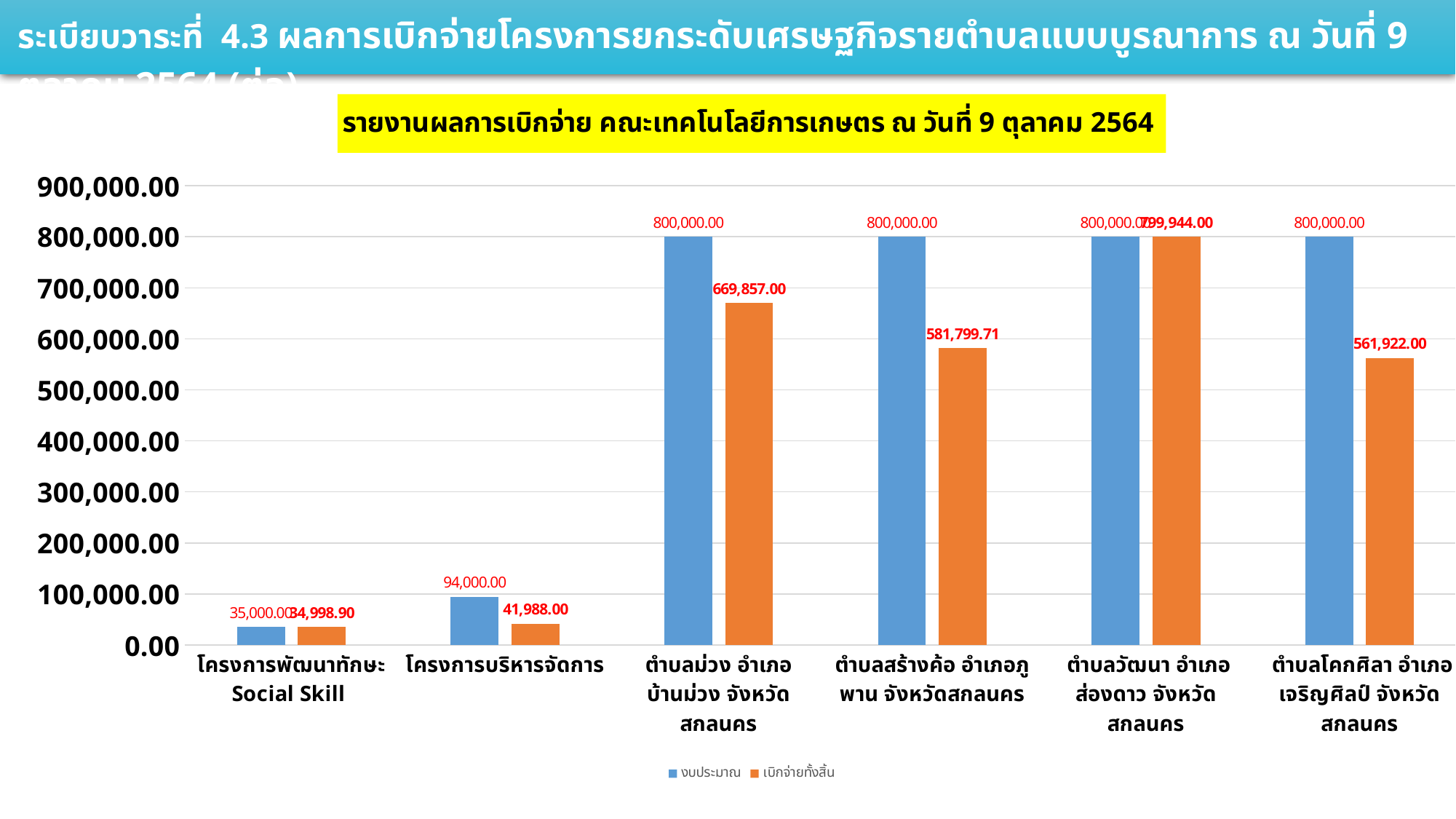
What is the เบิกจ่ายทั้งสิ้น value for ตำบลม่วง อำเภอบ้านม่วง จังหวัดสกลนคร? 669,857.00 How many series does the legend list? 2 What colour are the bars for the เบิกจ่ายทั้งสิ้น series? orange What is the เบิกจ่ายทั้งสิ้น value for ตำบลสร้างค้อ อำเภอภูพาน จังหวัดสกลนคร? 581,799.71 Which category has the lowest เบิกจ่ายทั้งสิ้น value? โครงการพัฒนาทักษะ Social Skill Is the เบิกจ่ายทั้งสิ้น value for ตำบลโคกศิลา อำเภอเจริญศิลป์ จังหวัดสกลนคร greater or less than 600,000.00? less What type of chart is shown on the slide? bar chart What is the difference between งบประมาณ and เบิกจ่ายทั้งสิ้น for โครงการบริหารจัดการ? 52,012.00 What is the งบประมาณ value for โครงการบริหารจัดการ? 94,000.00 Which is larger: the เบิกจ่ายทั้งสิ้น value for ตำบลม่วง อำเภอบ้านม่วง จังหวัดสกลนคร or for ตำบลสร้างค้อ อำเภอภูพาน จังหวัดสกลนคร? ตำบลม่วง อำเภอบ้านม่วง จังหวัดสกลนคร What is the เบิกจ่ายทั้งสิ้น value for ตำบลโคกศิลา อำเภอเจริญศิลป์ จังหวัดสกลนคร? 561,922.00 How many categories are shown on the x axis? 6